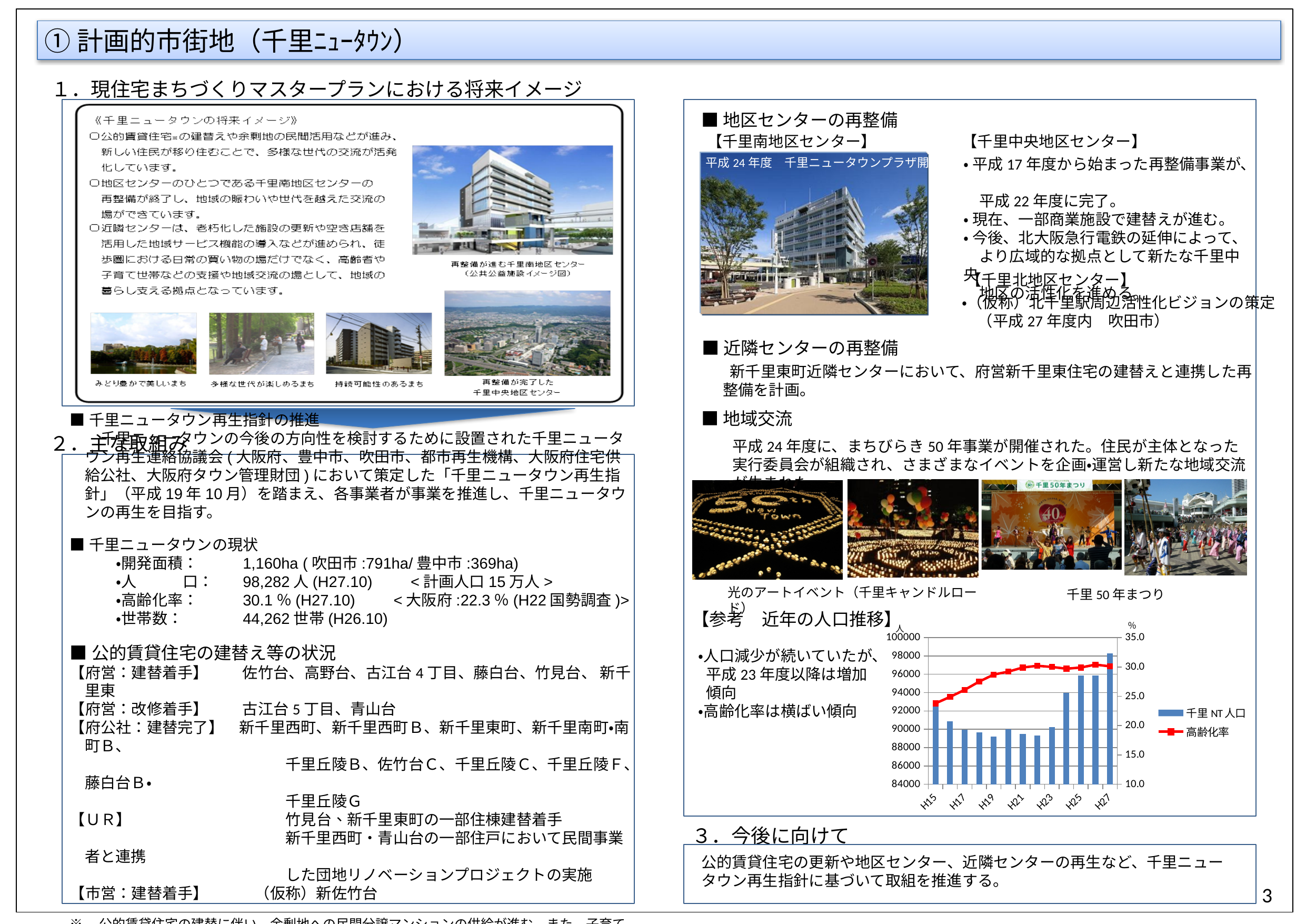
How many 千里NT人口 bars are plotted in the population chart? 13 In the population chart, is the 千里NT人口 value for H19 greater or less than 90000? less In the population chart, which year has the tallest 千里NT人口 bar? H27 In the population chart, is the 高齢化率 value for H15 greater or less than 25.0? less In the population chart, which is larger, the 千里NT人口 bar for H15 or for H27? H27 In the population chart, is the 千里NT人口 value for H15 greater or less than 92000? greater What kind of chart is shown under 【参考 近年の人口推移】? A bar chart combined with a line chart In the population chart, does the 高齢化率 line generally rise or fall from H15 to H27? rise How many series does the legend of the population chart list? 2 What are the two legend entries in the population chart? 千里NT人口 and 高齢化率 In the population chart, does the 千里NT人口 rise or fall from H23 to H27? rise